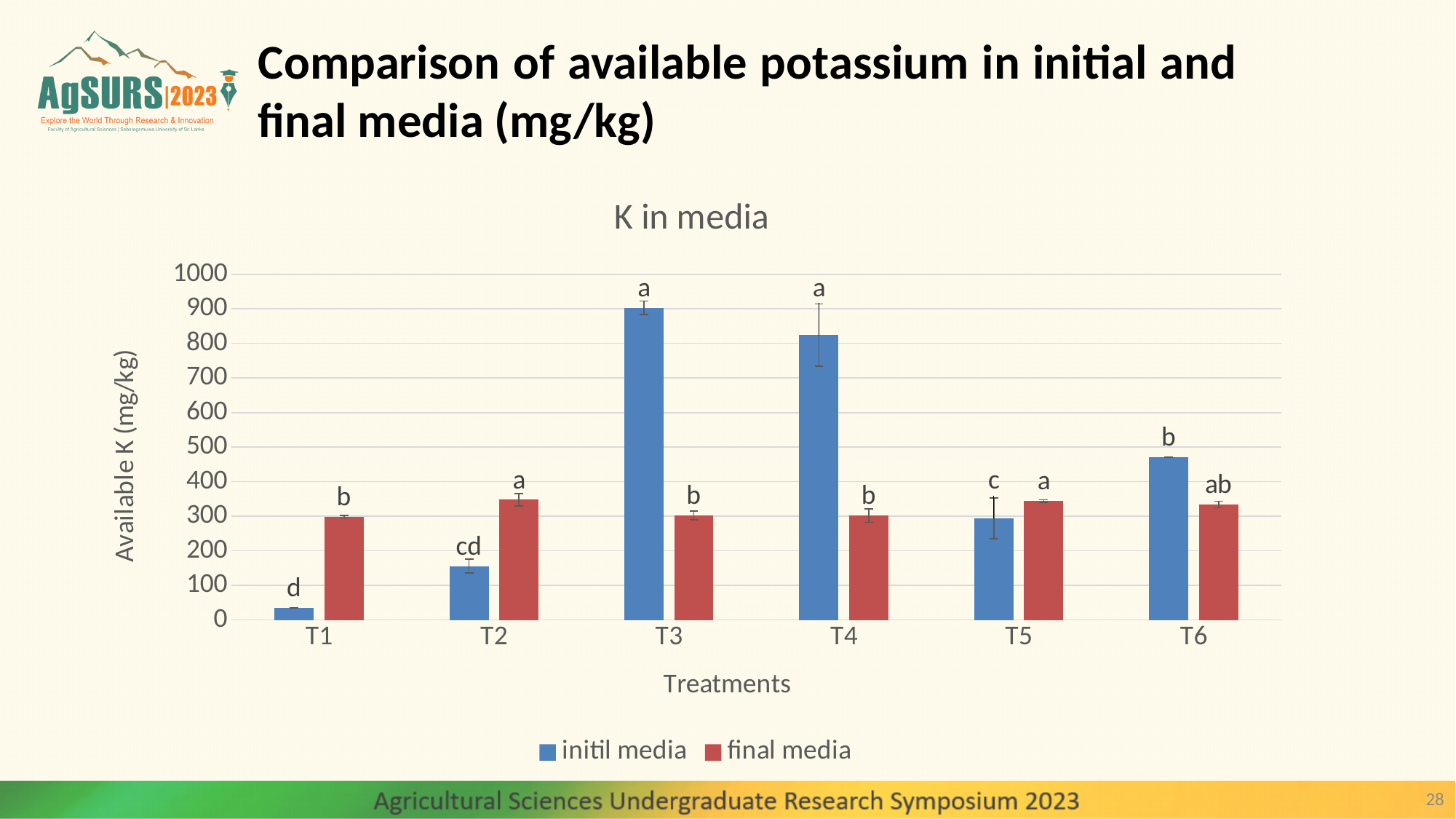
Is the initial media value for T4 greater or less than 700? greater Is the initial media value for T3 greater or less than 800? greater What is the label on the y axis of the chart? Available K (mg/kg) For T1, which is larger: the initial media value or the final media value? final media Which treatment has the highest initial media value? T3 Which treatment has the lowest initial media value? T1 How many treatments are shown on the x axis of the chart? 6 For T3, which is larger: the initial media value or the final media value? initial media Is the initial media value for T1 greater or less than 100? less What kind of chart is shown on the slide? bar chart How many series does the chart's legend list? 2